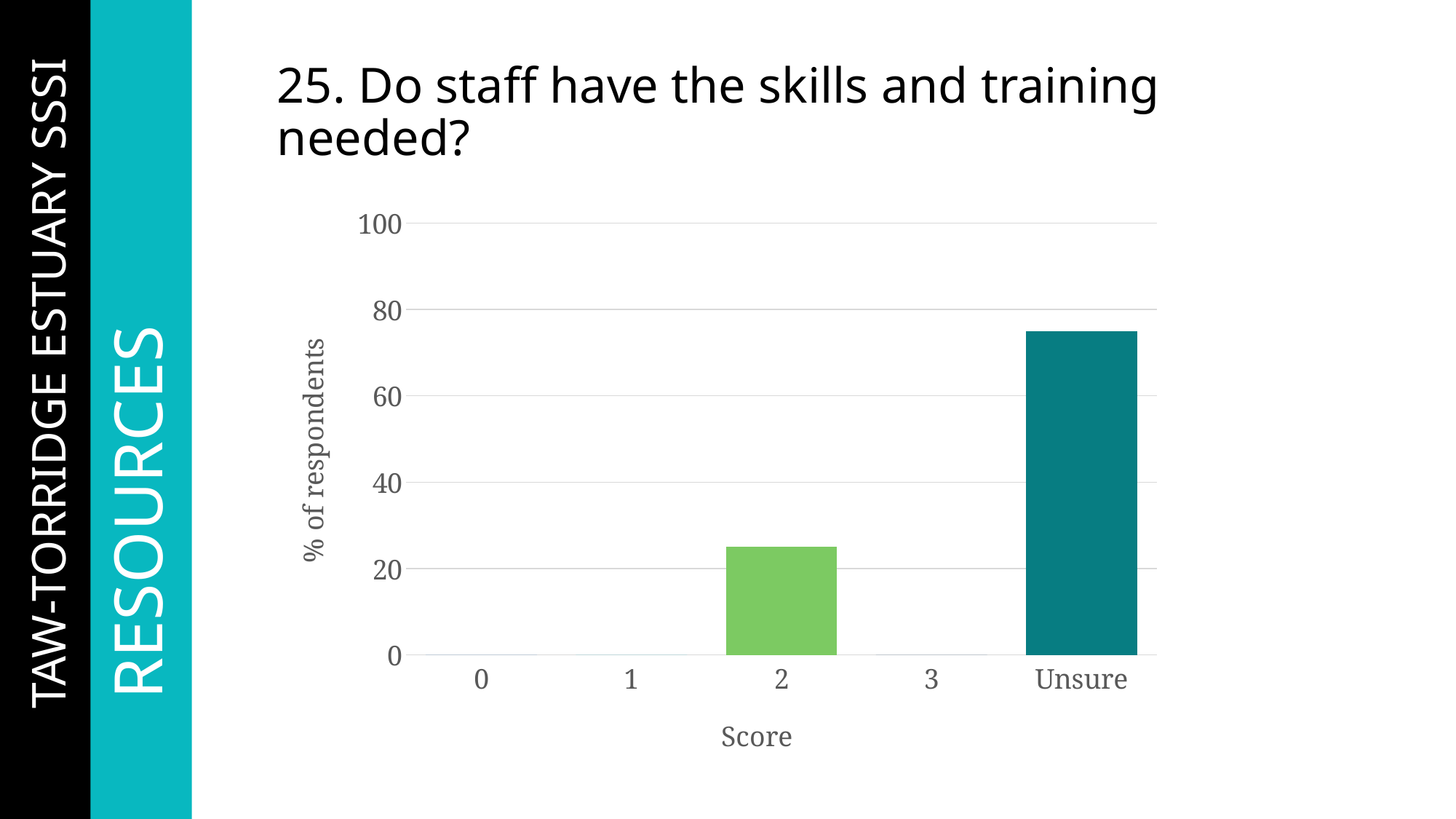
Which category has the highest value in the chart? Unsure Is the value for Unsure greater or less than 80? less How many categories are shown on the x axis of the chart? 5 What is the label of the x axis? Score What kind of chart is shown on the slide? bar chart Is the value for score 2 greater or less than 20? greater Is the value for score 2 greater or less than 40? less Which is larger, the value for Unsure or the value for score 2? Unsure How many categories have a visible bar in the chart? 2 What is the label of the y axis? % of respondents